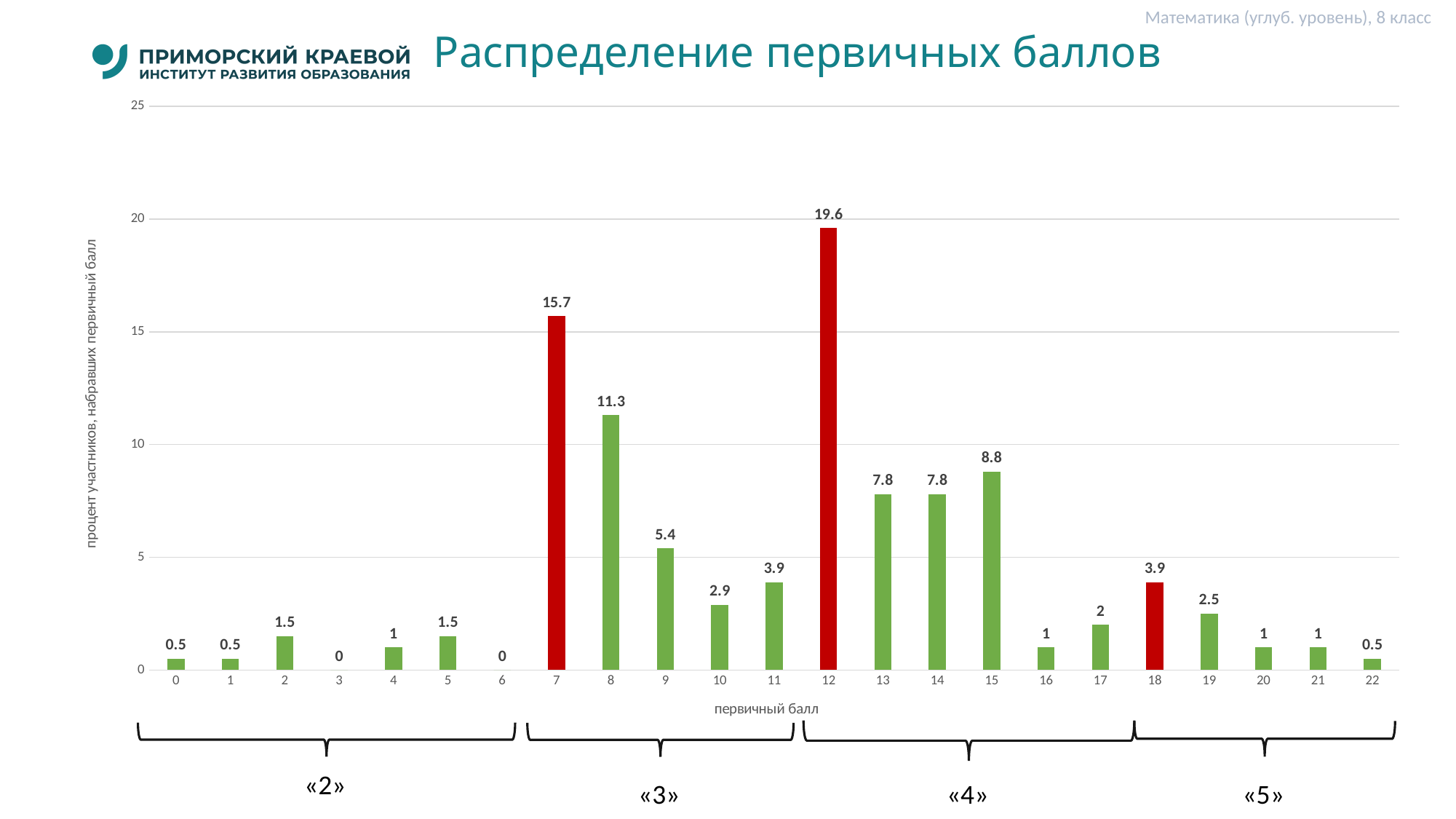
What is the difference between the values for primary scores 12 and 7? 3.9 What is the value for primary score 9? 5.4 What is the value for primary score 18? 3.9 Which primary scores have a value of 0? 3 and 6 What is the value for primary score 7? 15.7 How many primary score categories are shown on the x axis? 23 Which is larger, the value for primary score 15 or the value for primary score 13? 15 What is the difference between the values for primary scores 8 and 15? 2.5 Which primary scores are shown with red bars? 7, 12 and 18 What is the value for primary score 12? 19.6 Which primary score has the highest percentage of participants? 12 What kind of chart is shown on the slide? Bar chart